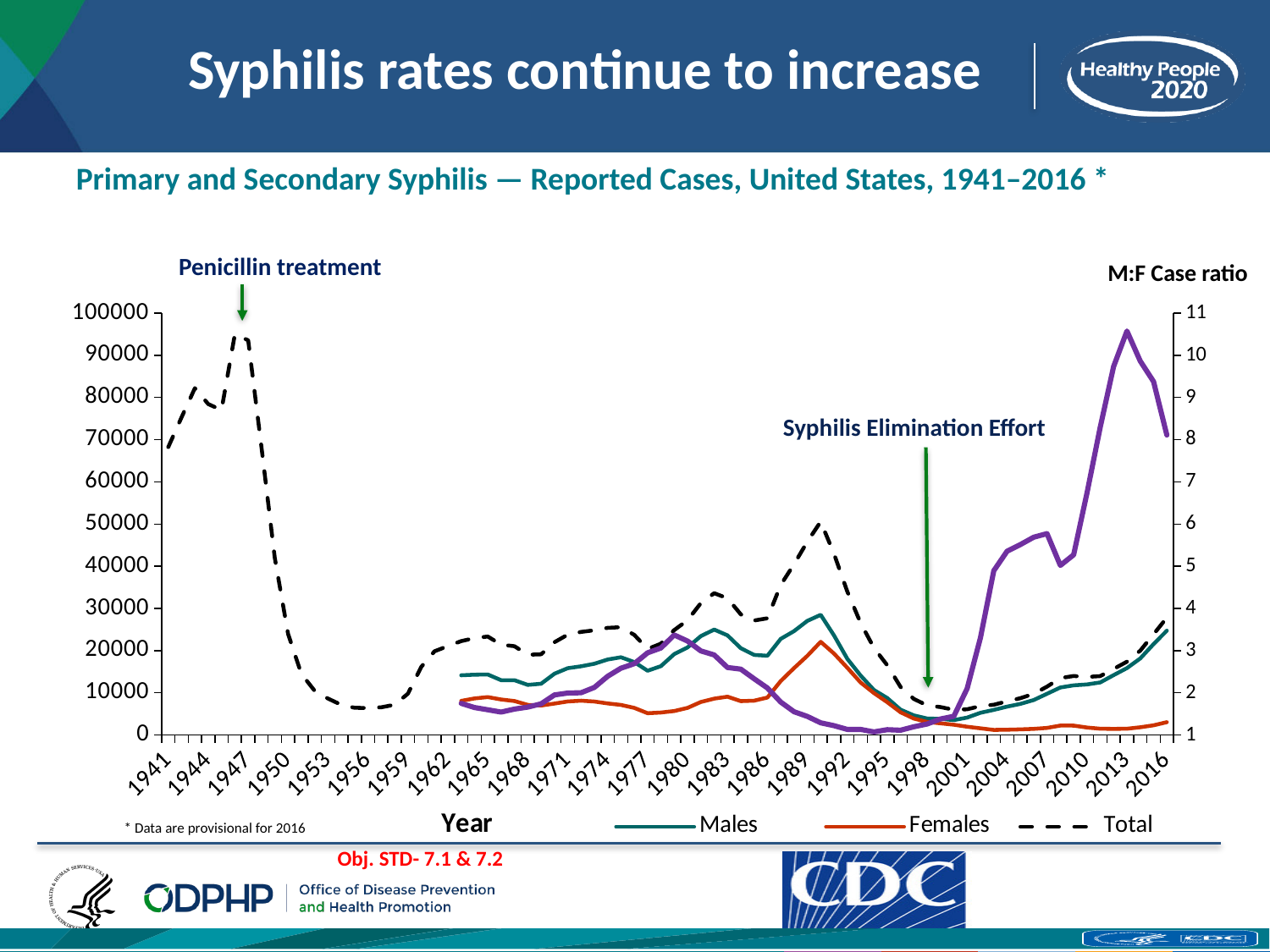
What is the label of the right-hand vertical axis? M:F Case ratio Is the Males value for 2016 greater or less than 20000? greater Is the Total value for 1956 greater or less than 10000? less Does the Total line rise or fall between 1947 and 1956? fall In 2016, which is larger, the Males value or the Females value? Males Is the Total value for 1947 greater or less than 80000? greater Does the Males line rise or fall between 2001 and 2016? rise How many series does the chart legend list? 3 What kind of chart is shown on the slide? line chart